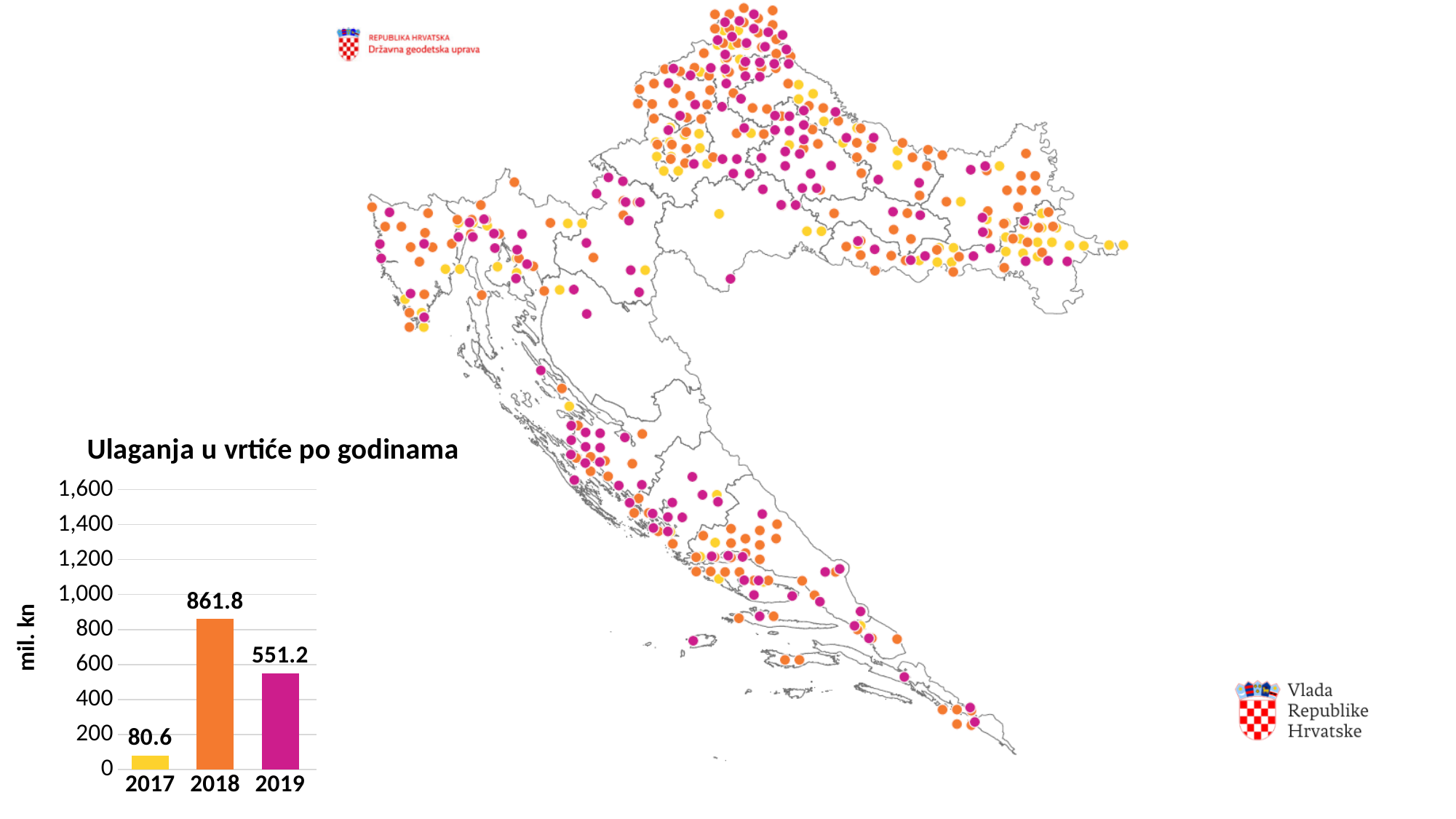
What is the label on the vertical axis of the chart 'Ulaganja u vrtiće po godinama'? mil. kn What is the difference between the values for 2018 and 2019 in the chart 'Ulaganja u vrtiće po godinama'? 310.6 How many years are shown in the chart 'Ulaganja u vrtiće po godinama'? 3 What is the value for 2019 in the chart 'Ulaganja u vrtiće po godinama'? 551.2 Which year has the lowest value in the chart 'Ulaganja u vrtiće po godinama'? 2017 What is the difference between the values for 2019 and 2017 in the chart 'Ulaganja u vrtiće po godinama'? 470.6 Which is larger in the chart 'Ulaganja u vrtiće po godinama', the value for 2017 or the value for 2019? 2019 Is the value for 2018 in the chart 'Ulaganja u vrtiće po godinama' greater or less than 800? greater Which year has the highest value in the chart 'Ulaganja u vrtiće po godinama'? 2018 What is the value for 2017 in the chart 'Ulaganja u vrtiće po godinama'? 80.6 What kind of chart is 'Ulaganja u vrtiće po godinama'? bar chart What is the value for 2018 in the chart 'Ulaganja u vrtiće po godinama'? 861.8